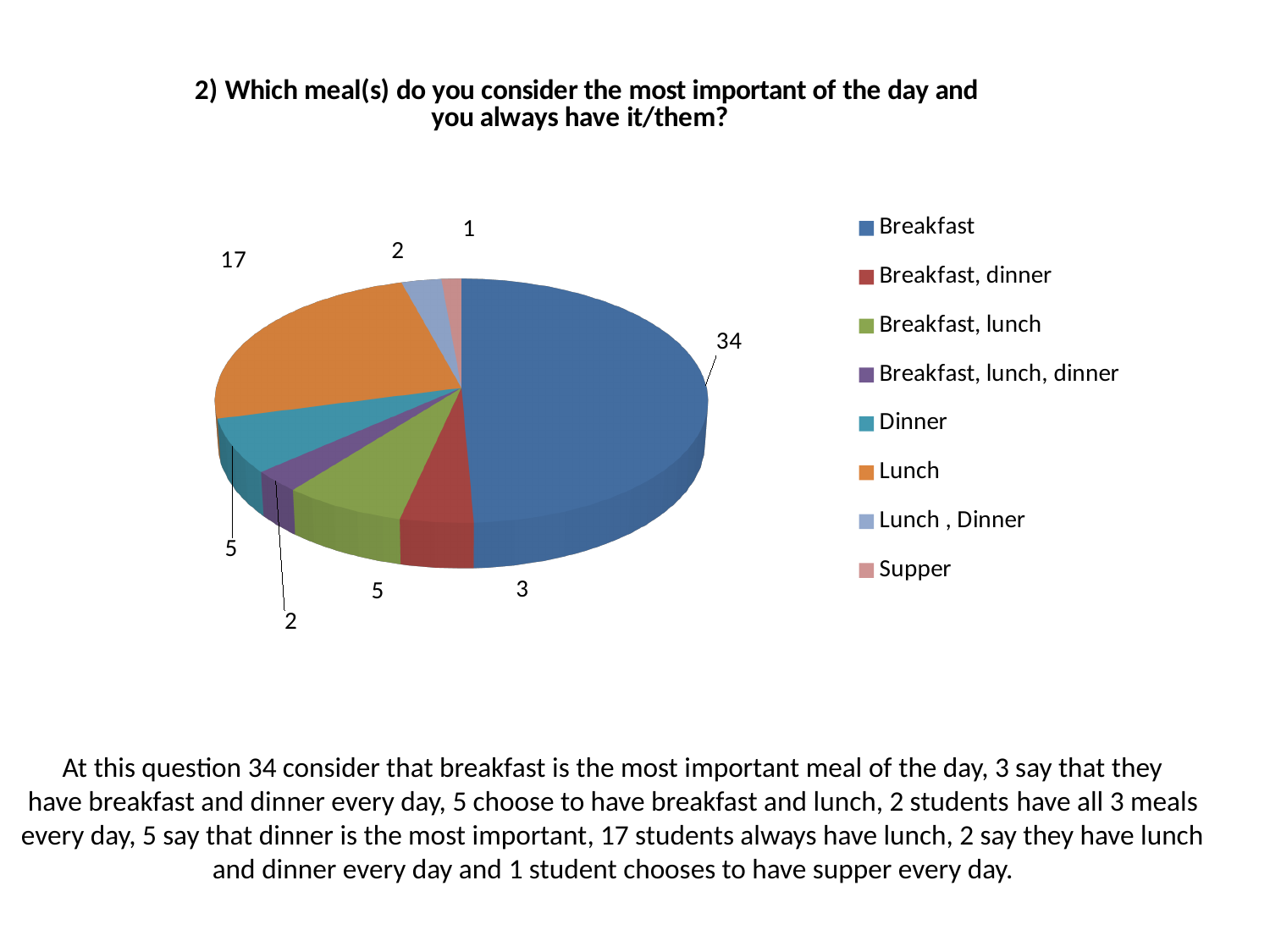
What is the value for the Lunch slice? 17 What colour is the Lunch slice in the pie chart? Orange How many students chose Breakfast as the most important meal? 34 What type of chart is shown on the slide? Pie chart What is the difference between the Breakfast value and the Lunch value? 17 How many categories does the legend list? 8 What is the value for the Supper slice? 1 Which category has the largest slice of the pie? Breakfast What is the value for the Breakfast, dinner slice? 3 What is the total of all the slice values in the pie chart? 69 Which is larger, the Breakfast, lunch slice or the Breakfast, dinner slice? Breakfast, lunch Which category has the smallest slice of the pie? Supper